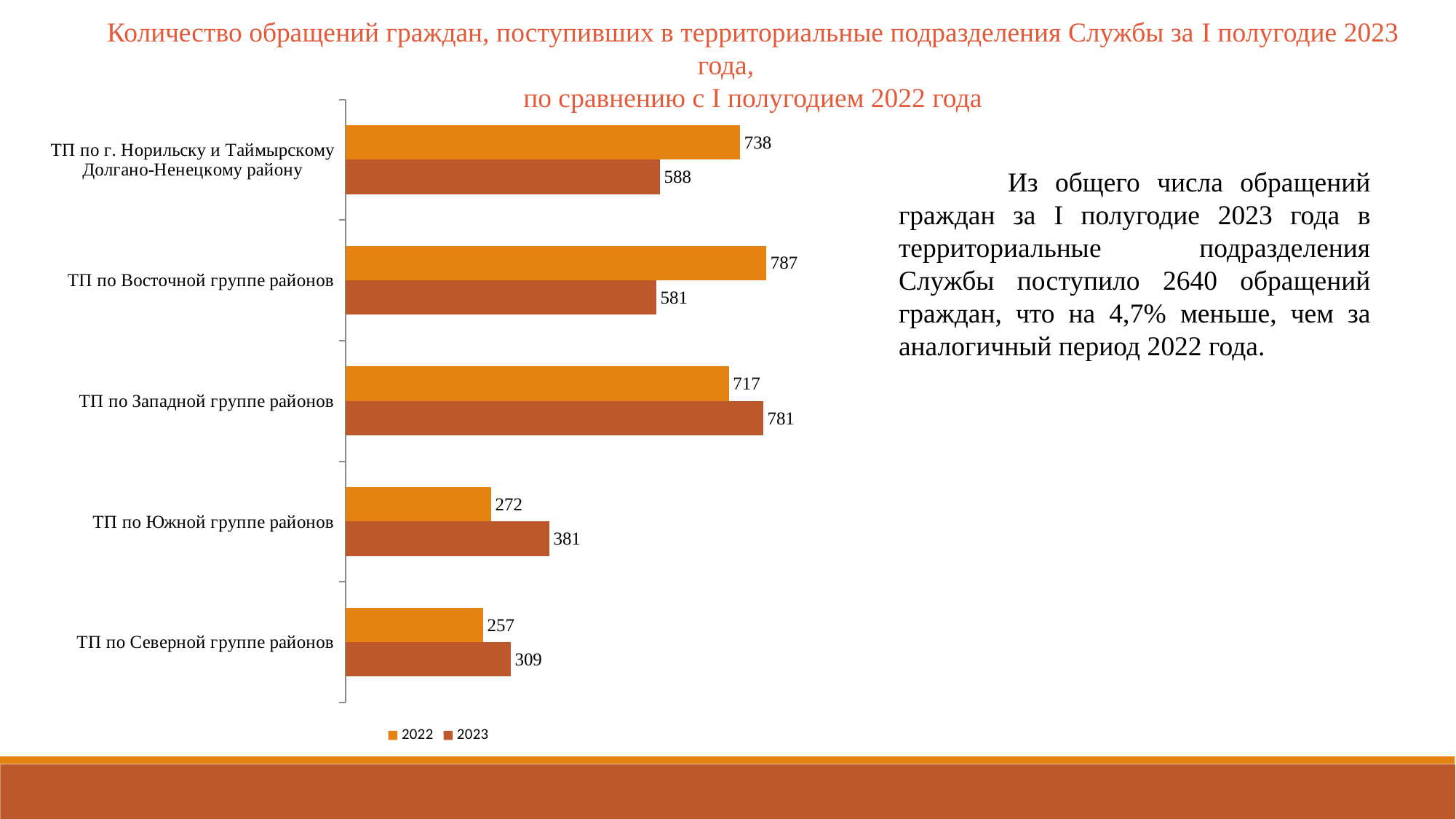
How many series does the legend list? 2 Which series does the darker orange-brown colour represent in the legend? 2023 What is the 2022 value for ТП по Восточной группе районов? 787 Which category has the highest 2022 value? ТП по Восточной группе районов How many categories are shown on the chart? 5 What kind of chart is shown on the slide? Bar chart Which category has the lowest 2023 value? ТП по Северной группе районов What is the 2023 value for ТП по Западной группе районов? 781 What is the difference between the 2022 and 2023 values for ТП по Восточной группе районов? 206 What is the difference between the 2022 and 2023 values for ТП по Южной группе районов? 109 For ТП по Западной группе районов, which is larger: the 2022 value or the 2023 value? 2023 What is the 2023 value for ТП по г. Норильску и Таймырскому Долгано-Ненецкому району? 588